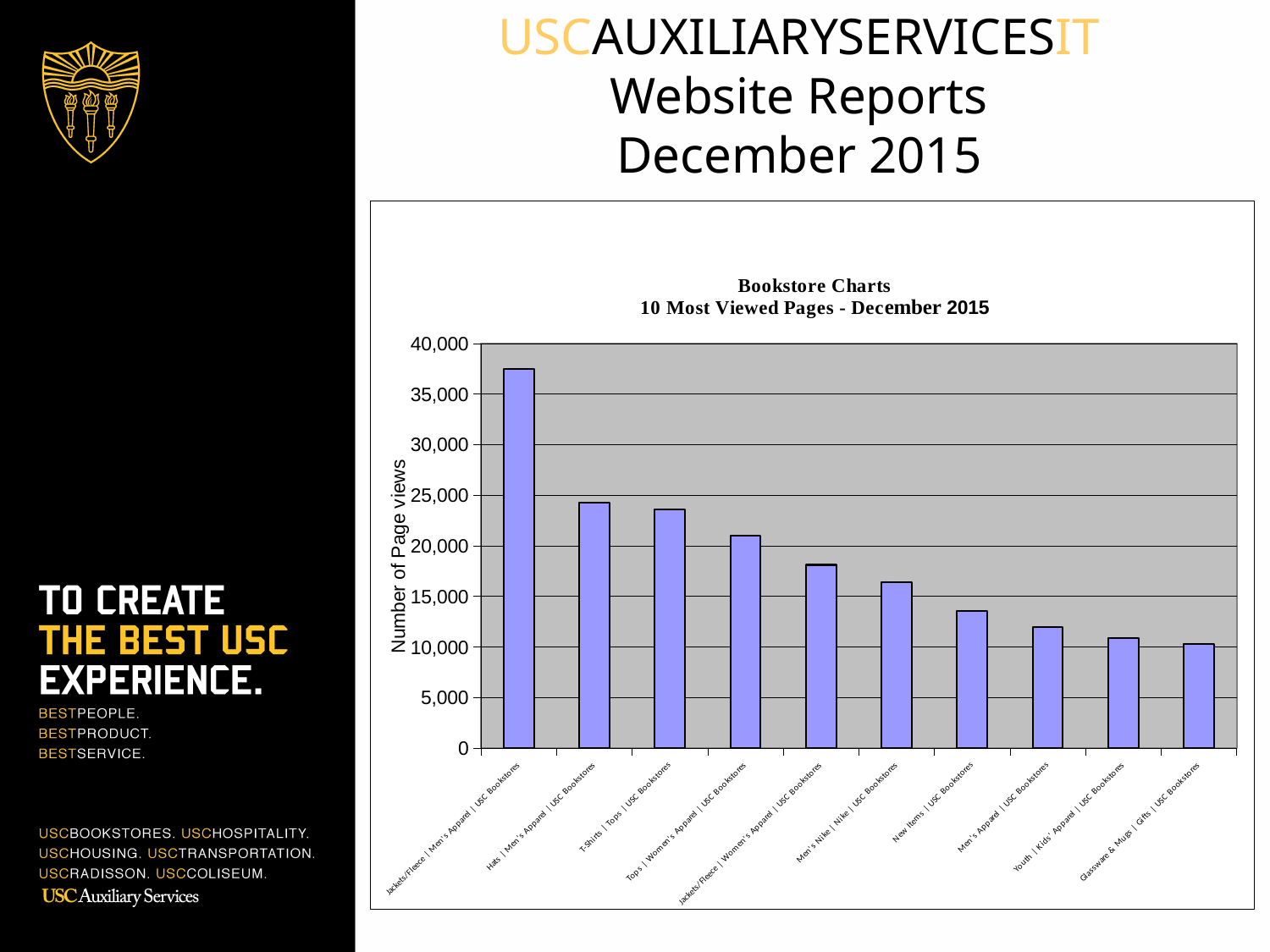
Is the value for Hats | Men's Apparel | USC Bookstores greater or less than 25,000? less Do the page view values rise or fall from left to right across the chart? Fall What kind of chart is shown on the slide? Bar chart What is the label on the vertical axis of the chart? Number of Page views What is the title of the chart? Bookstore Charts 10 Most Viewed Pages - December 2015 Is the value for New Items | USC Bookstores greater or less than 15,000? less How many pages (bars) are shown in the chart? 10 Is the value for Jackets/Fleece | Men's Apparel | USC Bookstores greater or less than 35,000? greater Which page has the lowest number of page views? Glassware & Mugs | Gifts | USC Bookstores Which page has the highest number of page views? Jackets/Fleece | Men's Apparel | USC Bookstores Which has more page views: Tops | Women's Apparel | USC Bookstores or Jackets/Fleece | Women's Apparel | USC Bookstores? Tops | Women's Apparel | USC Bookstores